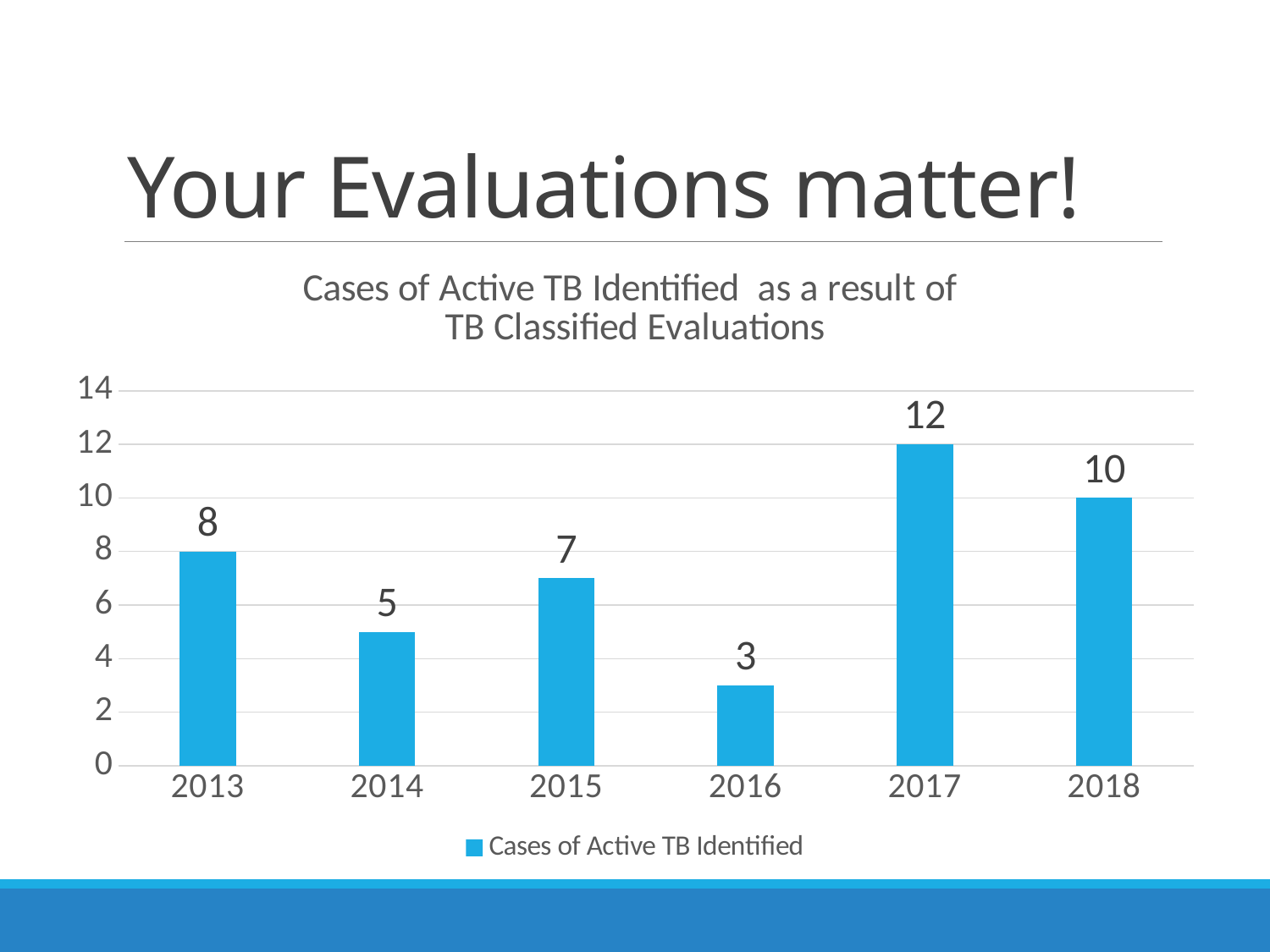
How many years are shown on the x axis? 6 Which year has the highest number of cases of active TB identified? 2017 What is the value shown for 2014? 5 How many series does the legend list? 1 What kind of chart is shown on the slide? Bar chart Is the value for 2018 greater or less than 8? greater What is the title of the chart? Cases of Active TB Identified as a result of TB Classified Evaluations Do the values rise or fall from 2016 to 2017? Rise Which year has a larger value, 2013 or 2015? 2013 How many cases of active TB were identified in 2017? 12 Which year has the lowest number of cases of active TB identified? 2016 What is the difference between the values for 2017 and 2016? 9